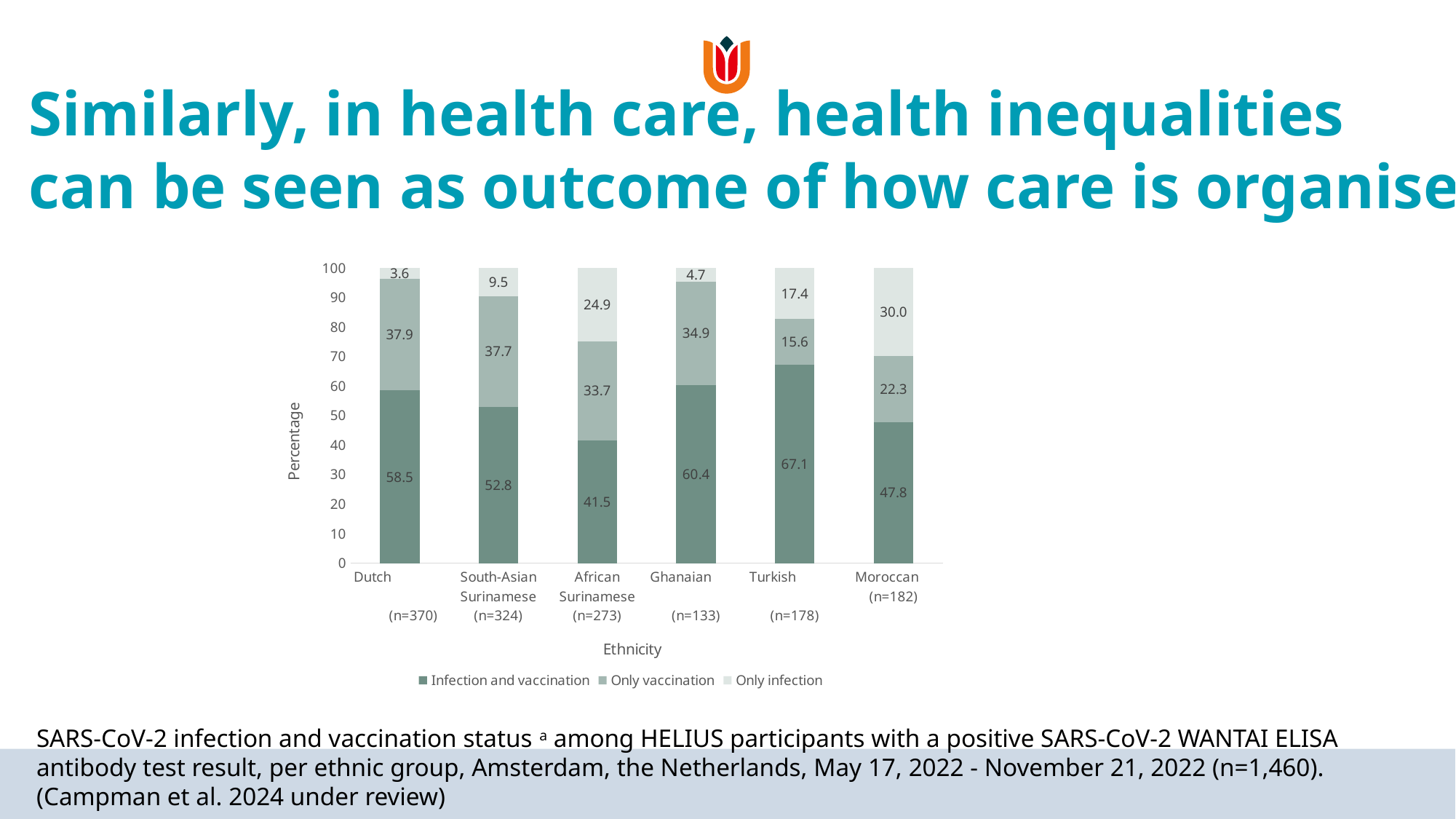
What is the Only infection value for the Moroccan group? 30.0 Which ethnic group has the lowest Only infection value? Dutch Which ethnic group has the highest Infection and vaccination value? Turkish How many series does the legend list? 3 What kind of chart is shown on the slide? Stacked bar chart What is the label of the y axis? Percentage What is the Only vaccination value for the Turkish group? 15.6 What is the difference between the Only infection values for the Moroccan and Dutch groups? 26.4 What is the value for Infection and vaccination for the Dutch group? 58.5 Which is larger: the Only vaccination value for the Dutch group or for the Ghanaian group? Dutch Is the Infection and vaccination value for the African Surinamese group greater or less than 50? less How many ethnic groups are shown on the x axis? 6